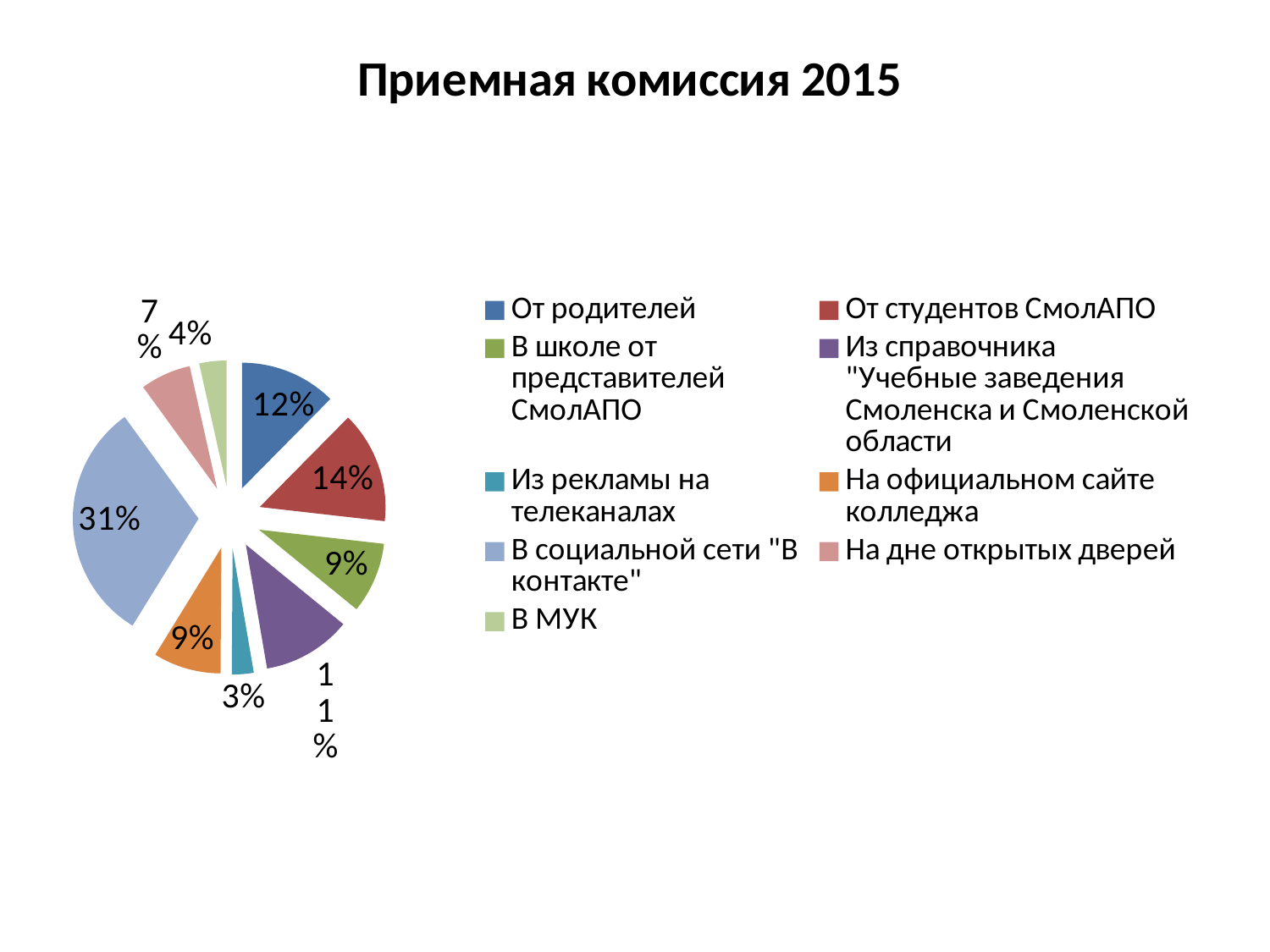
What type of chart is shown on the slide? pie chart What is the value for "От студентов СмолАПО"? 14% What is the value for "На дне открытых дверей"? 7% What is the value for "От родителей"? 12% What share of the pie is "В социальной сети "В контакте""? 31% Which is larger, the share for "В МУК" or the share for "На дне открытых дверей"? На дне открытых дверей Which category has the smallest share of the pie? Из рекламы на телеканалах What is the title of the chart on the slide? Приемная комиссия 2015 How many slices does the pie chart have? 9 What is the difference between the shares for "От студентов СмолАПО" and "От родителей"? 2% What is the value for "Из рекламы на телеканалах"? 3% Which category has the largest share of the pie? В социальной сети "В контакте"